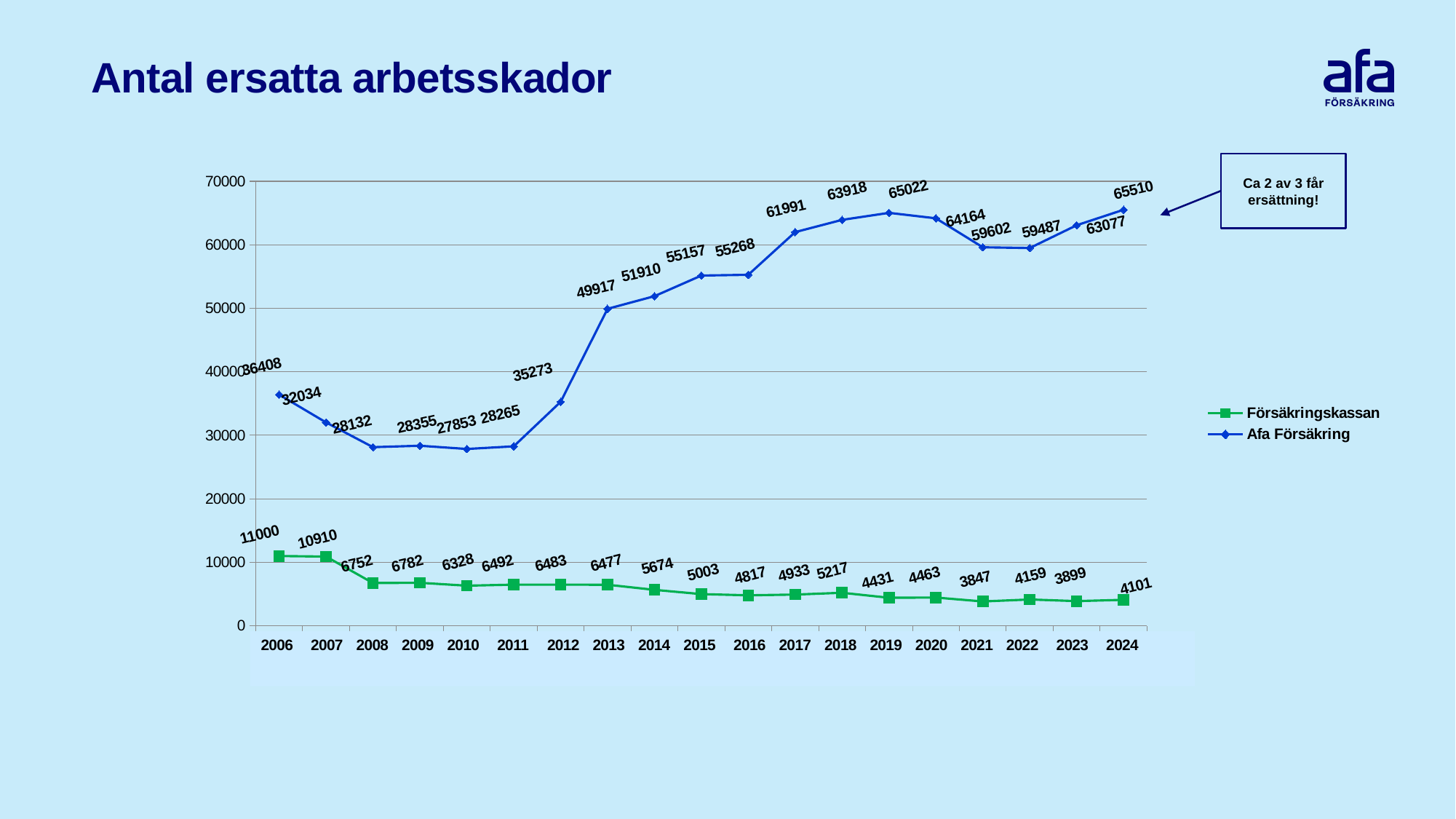
In which year is the Afa Försäkring value highest? 2024 What is the value for Afa Försäkring in 2024? 65510 How many series does the legend list? 2 What type of chart is shown on the slide? Line chart Which series has the larger value in 2012, Afa Försäkring or Försäkringskassan? Afa Försäkring What is the value for Afa Försäkring in 2013? 49917 In which year is the Försäkringskassan value lowest? 2021 What is the value for Försäkringskassan in 2006? 11000 How many years are plotted along the x axis? 19 In which year is the Afa Försäkring value lowest? 2010 What is the title of the chart? Antal ersatta arbetsskador What is the difference between the Afa Försäkring and Försäkringskassan values in 2024? 61409